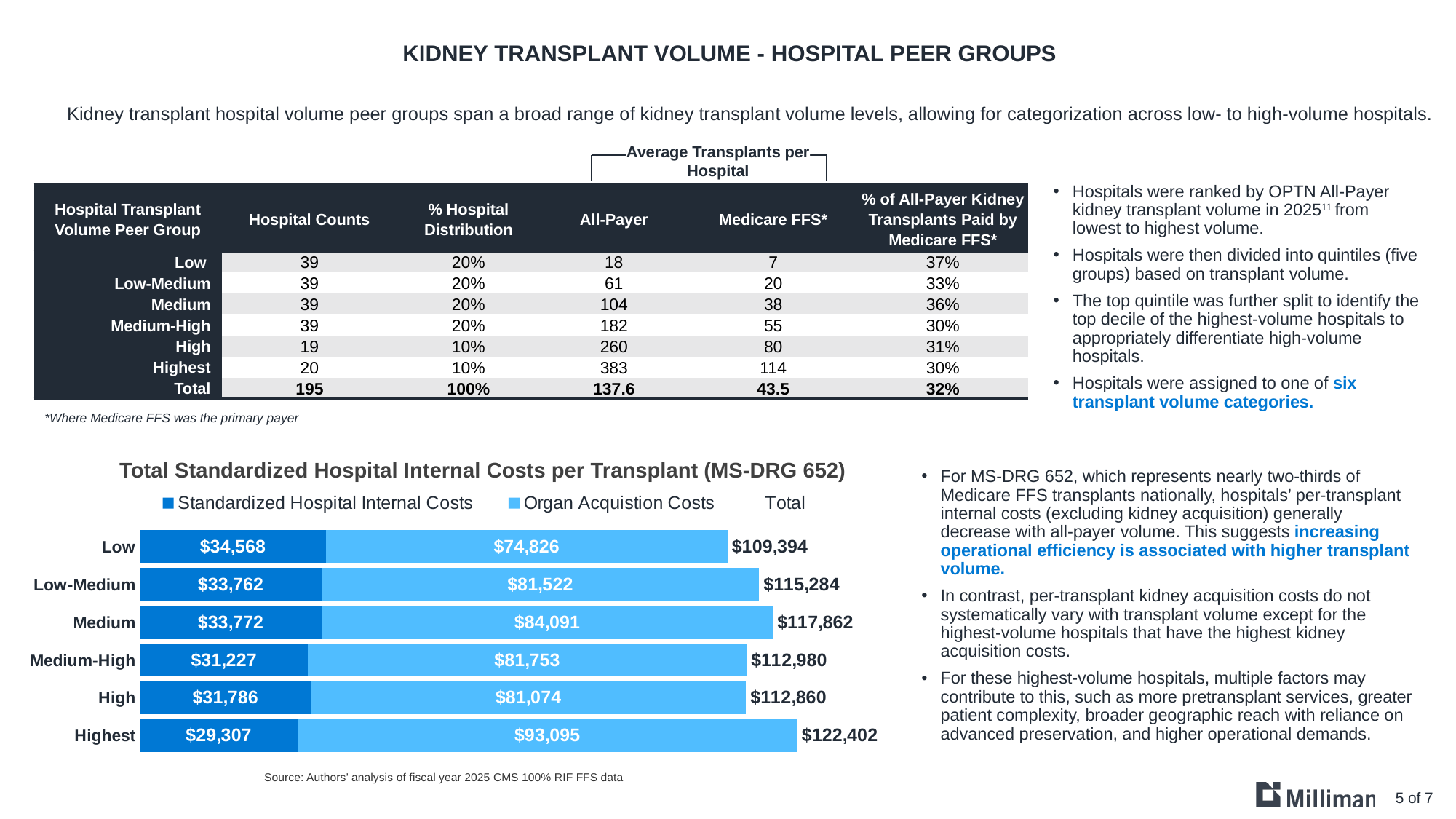
In the Total Standardized Hospital Internal Costs per Transplant chart, do Standardized Hospital Internal Costs generally rise or fall from the Low group to the Highest group? Fall In the Total Standardized Hospital Internal Costs per Transplant chart, what is the Organ Acquisition Costs value for the Highest peer group? $93,095 In the Total Standardized Hospital Internal Costs per Transplant chart, how much higher are Organ Acquisition Costs for the Highest group than for the Low group? $18,269 What kind of chart is the Total Standardized Hospital Internal Costs per Transplant chart? Stacked bar chart In the Total Standardized Hospital Internal Costs per Transplant chart, which peer group has the lowest Standardized Hospital Internal Costs? Highest In the Total Standardized Hospital Internal Costs per Transplant chart, what is the Standardized Hospital Internal Costs value for the Low peer group? $34,568 In the Total Standardized Hospital Internal Costs per Transplant chart, which has larger Standardized Hospital Internal Costs, the Low group or the Highest group? Low In the Total Standardized Hospital Internal Costs per Transplant chart, what is the total cost per transplant for the Medium peer group? $117,862 How many peer groups are shown in the Total Standardized Hospital Internal Costs per Transplant chart? 6 In the Total Standardized Hospital Internal Costs per Transplant chart, what is the difference between the total for the Highest group and the total for the Low group? $13,008 In the Total Standardized Hospital Internal Costs per Transplant chart, which peer group has the highest total cost per transplant? Highest How many entries does the legend of the Total Standardized Hospital Internal Costs per Transplant chart list? 3